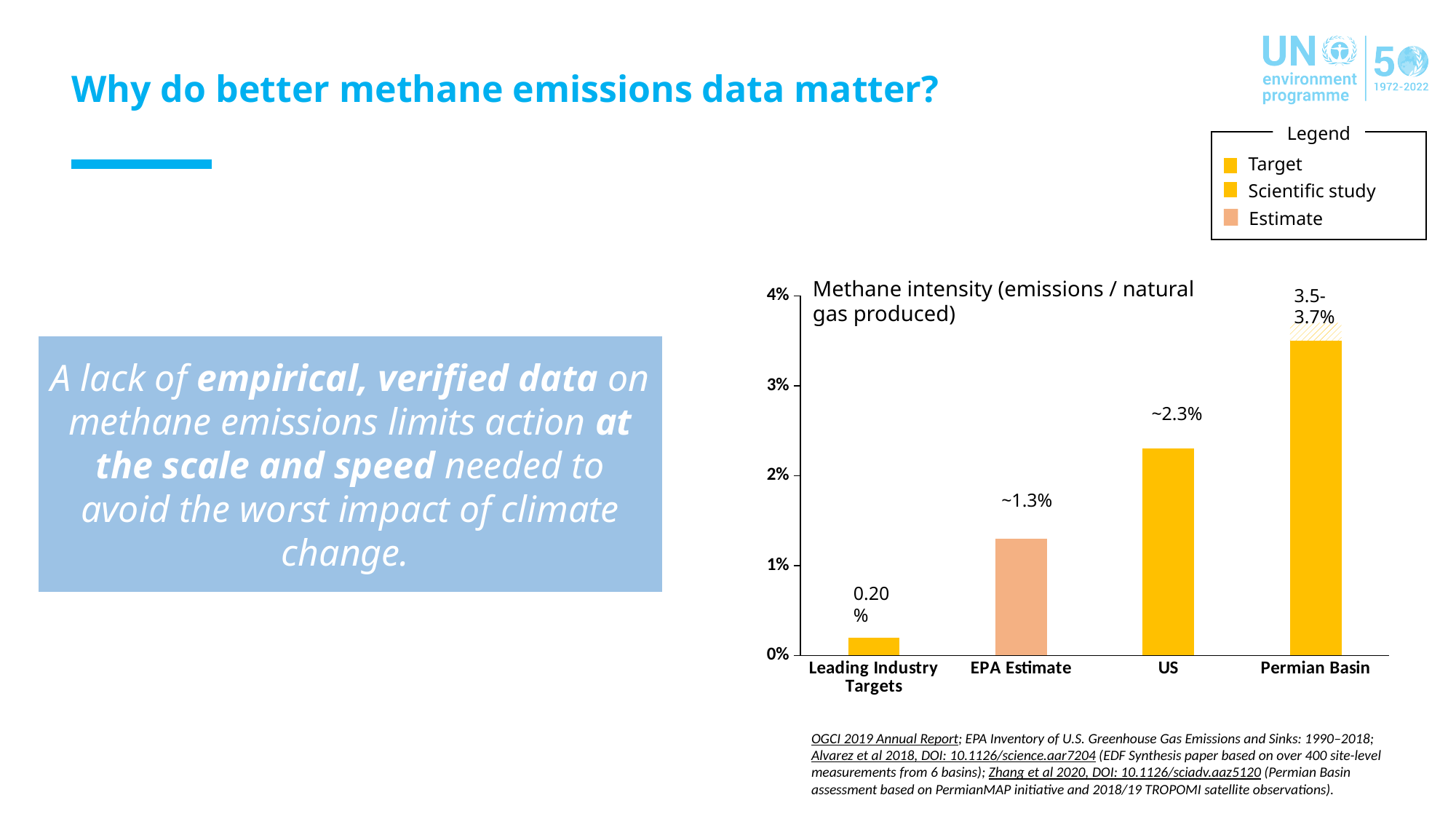
What label is printed above the EPA Estimate bar? ~1.3% What is the title of the chart? Methane intensity (emissions / natural gas produced) How many categories are shown on the x axis of the chart? 4 Which is larger, the value for US or the value for EPA Estimate? US What type of chart is shown on the slide? bar chart Is the value for US greater or less than 3%? less Which category has the highest methane intensity? Permian Basin How many entries does the legend list? 3 What value is printed above the Leading Industry Targets bar? 0.20% Which category has the lowest methane intensity? Leading Industry Targets What label is printed above the Permian Basin bar? 3.5-3.7% Do the bar values rise or fall from left to right along the x axis? rise